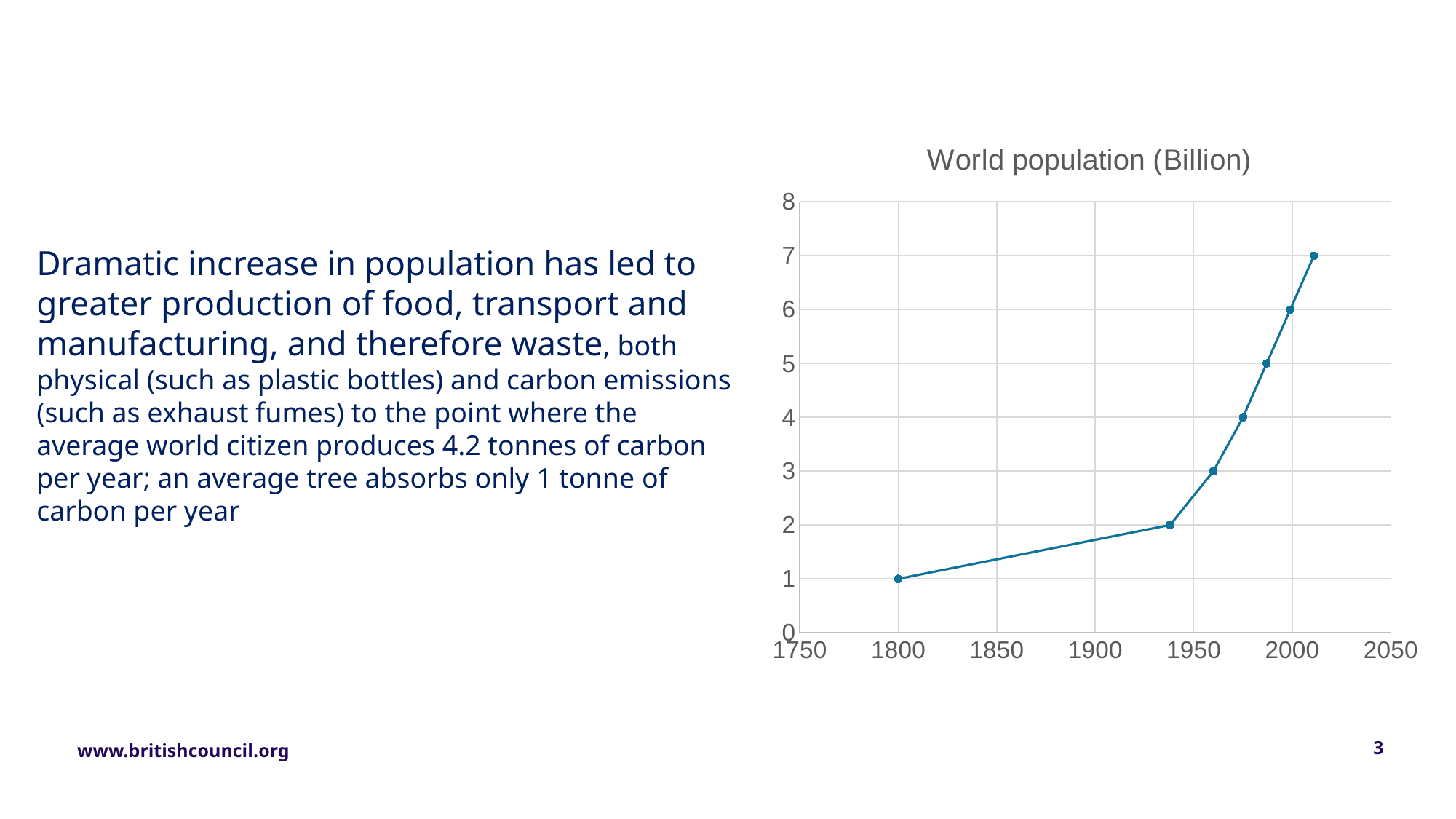
Is the value of the rightmost point greater or less than 6? greater What is the title of the chart? World population (Billion) What kind of chart is shown on the slide? line chart What is the highest value plotted on the chart? 7 Is the value plotted at 1800 greater or less than 4? less Do the values rise or fall as the years increase along the x axis? rise What is the highest tick value shown on the y axis? 8 What is the lowest value plotted on the chart? 1 What is the difference between the highest and lowest plotted values? 6 What is the world population value plotted at 1800? 1 What is the value of the rightmost (latest) point on the line? 7 How many data points are plotted on the line? 7